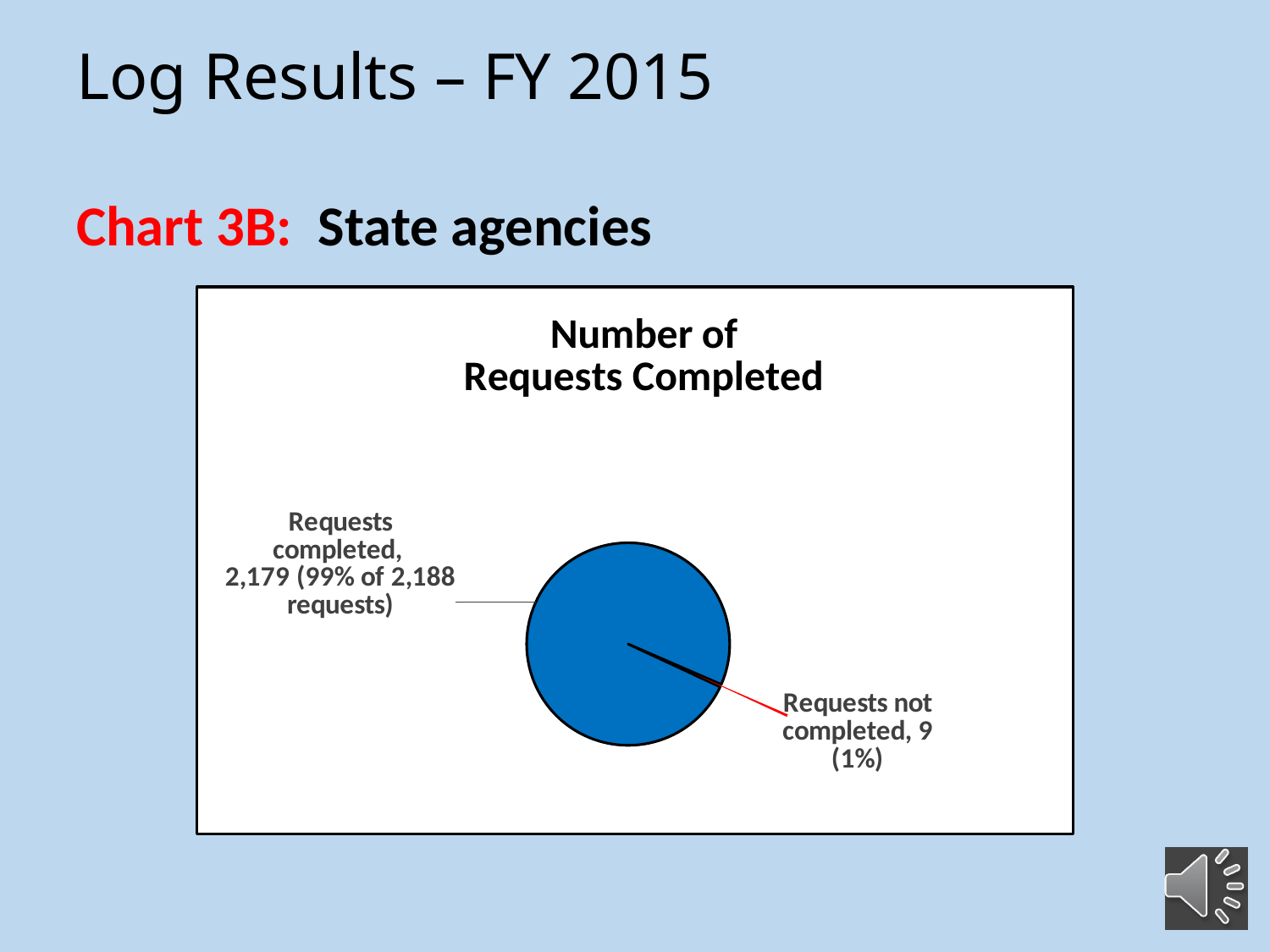
What is the total number of requests shown in the chart? 2,188 What kind of chart is shown on the slide? pie chart How many requests were completed according to the chart? 2,179 How many requests were not completed according to the chart? 9 How many slices does the pie chart have? 2 Which slice of the pie is the smallest? Requests not completed What is the difference between the number of requests completed and the number not completed? 2,170 What share of the pie does the 'Requests not completed' slice represent? 1% What is the title of the chart? Number of Requests Completed Which slice of the pie is the largest? Requests completed What share of the pie does the 'Requests completed' slice represent? 99% Which is larger: the number of requests completed or the number of requests not completed? Requests completed